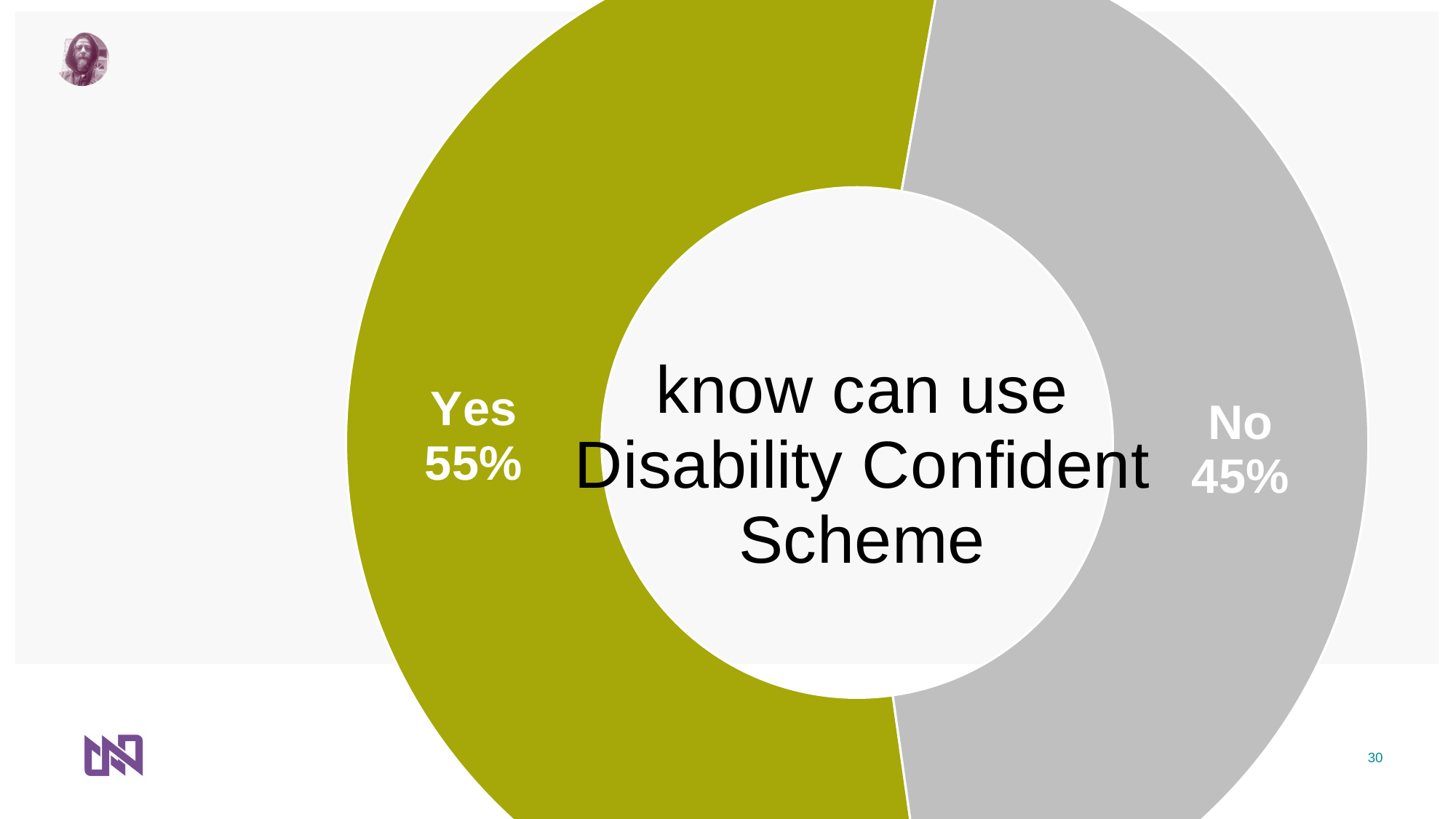
What share of the chart does the Yes slice represent? 55% What colour is the Yes segment of the chart? Green (olive/yellow-green) What is the difference in percentage points between the Yes and No shares? 10 percentage points Which category has the largest share in the chart? Yes Which category has the smallest share in the chart? No What percentage of respondents answered No to knowing they can use the Disability Confident Scheme? 45% What text appears in the centre of the doughnut chart? know can use Disability Confident Scheme How many categories are shown in the chart? 2 Which response has the larger share of the chart, Yes or No? Yes What percentage of respondents answered Yes to knowing they can use the Disability Confident Scheme? 55% What kind of chart is shown on the slide? Doughnut (pie) chart